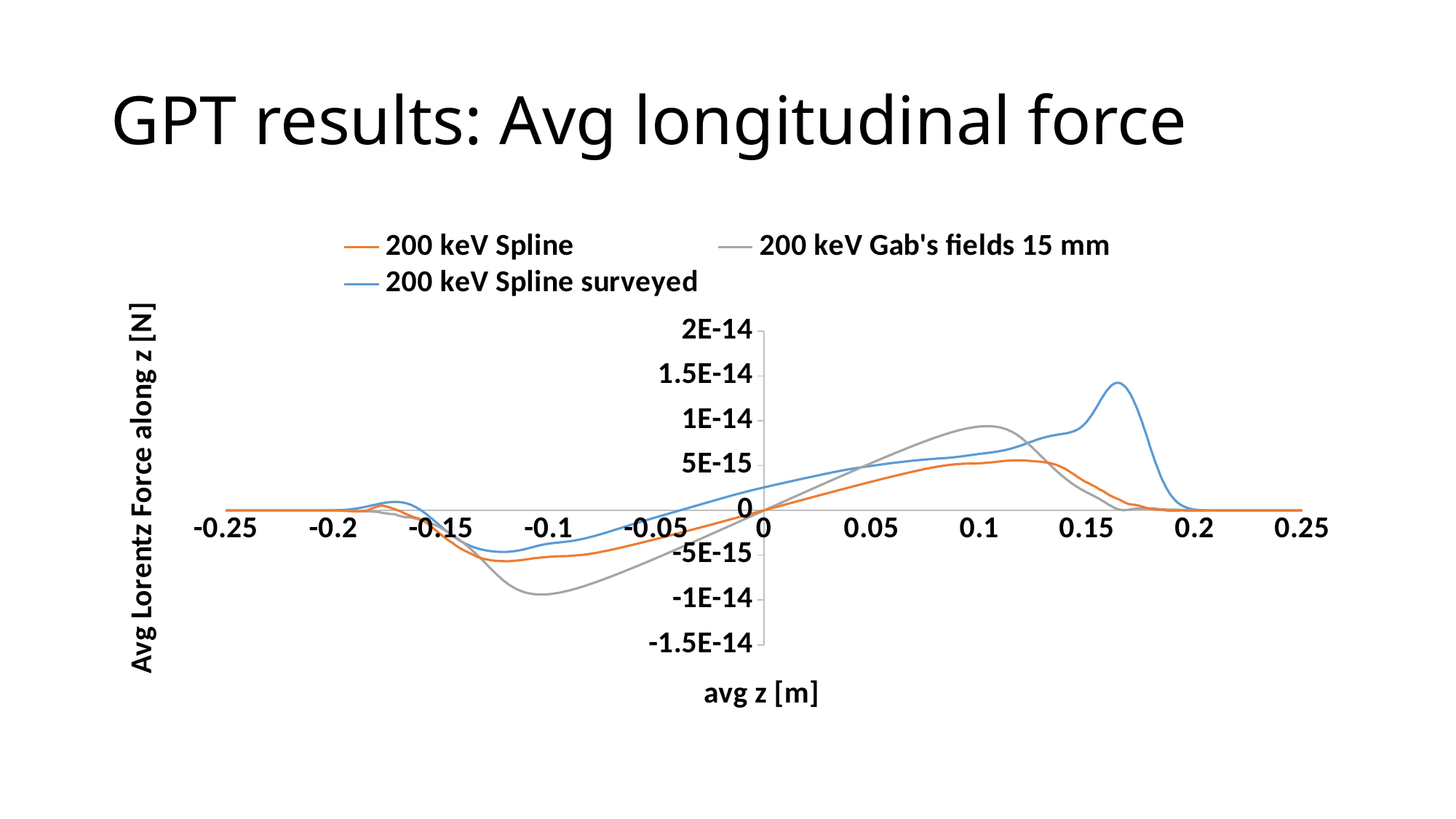
What is the title of the x axis? avg z [m] Is the minimum value of the 200 keV Gab's fields 15 mm series greater or less than -5E-15? less What are the three series named in the legend? 200 keV Spline, 200 keV Gab's fields 15 mm, 200 keV Spline surveyed What kind of chart is shown on the slide? line chart How many series does the legend list? 3 Is the peak value of the 200 keV Spline surveyed series greater or less than 1E-14? greater At avg z = 0.1 m, which series has the larger value: 200 keV Gab's fields 15 mm or 200 keV Spline? 200 keV Gab's fields 15 mm Which series reaches the highest peak value on the chart? 200 keV Spline surveyed Which series reaches the lowest (most negative) value on the chart? 200 keV Gab's fields 15 mm At avg z = -0.1 m, which series has the lower value: 200 keV Gab's fields 15 mm or 200 keV Spline surveyed? 200 keV Gab's fields 15 mm Is the peak value of the 200 keV Spline series greater or less than 1E-14? less Between avg z = 0 and avg z = 0.1 m, does the 200 keV Gab's fields 15 mm series rise or fall? rise